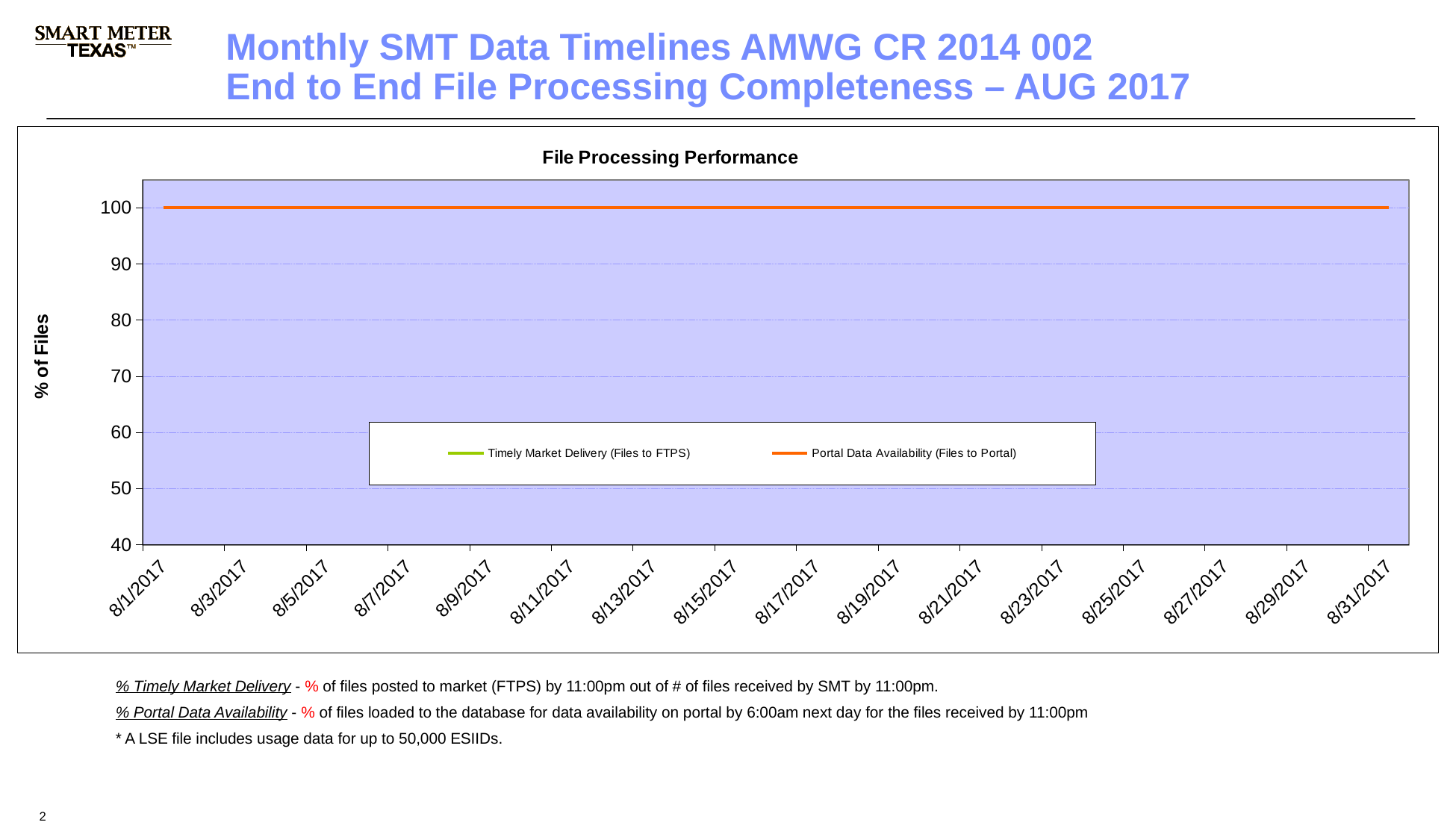
What is the difference between the Portal Data Availability values on 8/3/2017 and 8/29/2017? 0 Do the plotted values rise, fall, or stay flat from 8/1/2017 to 8/31/2017? stay flat What kind of chart is shown under the title "File Processing Performance"? line chart Is the value for Portal Data Availability on 8/21/2017 greater or less than 90? greater What is the value for Portal Data Availability (Files to Portal) on 8/15/2017? 100 What is the lowest value shown on the y axis of the chart? 40 How many series does the legend of the File Processing Performance chart list? 2 What is the value for Portal Data Availability (Files to Portal) on 8/1/2017? 100 What is the label of the y axis of the chart? % of Files How many date labels are shown along the x axis of the chart? 16 Is the value for Portal Data Availability on 8/9/2017 greater or less than 50? greater What is the title of the chart on the slide? File Processing Performance